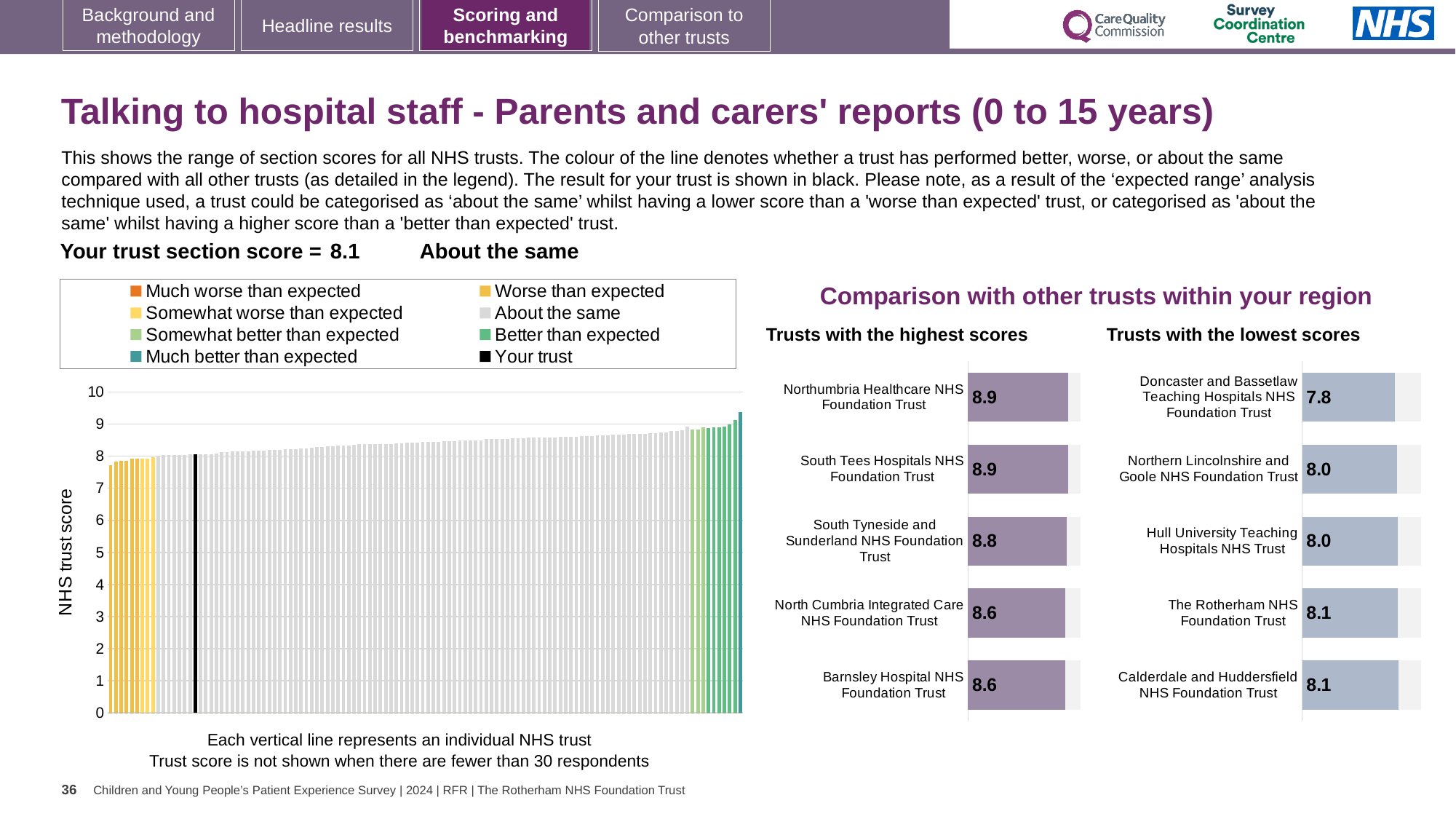
How many entries does the legend of the left-hand chart list? 8 How many trusts are shown in the 'Trusts with the highest scores' chart? 5 In the 'Trusts with the highest scores' chart, what is the score for South Tyneside and Sunderland NHS Foundation Trust? 8.8 What is the label on the vertical axis of the left-hand chart? NHS trust score In the left-hand chart of all NHS trusts, do the bars rise or fall from left to right? rise Which has the higher score: South Tyneside and Sunderland NHS Foundation Trust in the highest scores chart, or Hull University Teaching Hospitals NHS Trust in the lowest scores chart? South Tyneside and Sunderland NHS Foundation Trust What is the section score for your trust shown on the slide? 8.1 What kind of chart is the large chart on the left showing all NHS trusts? bar chart In the 'Trusts with the lowest scores' chart, which trust has the lowest score? Doncaster and Bassetlaw Teaching Hospitals NHS Foundation Trust In the 'Trusts with the lowest scores' chart, what is the difference between the scores of The Rotherham NHS Foundation Trust and Doncaster and Bassetlaw Teaching Hospitals NHS Foundation Trust? 0.3 In the 'Trusts with the highest scores' chart, what is the difference between the scores of Northumbria Healthcare NHS Foundation Trust and Barnsley Hospital NHS Foundation Trust? 0.3 In the 'Trusts with the lowest scores' chart, what is the score for Doncaster and Bassetlaw Teaching Hospitals NHS Foundation Trust? 7.8